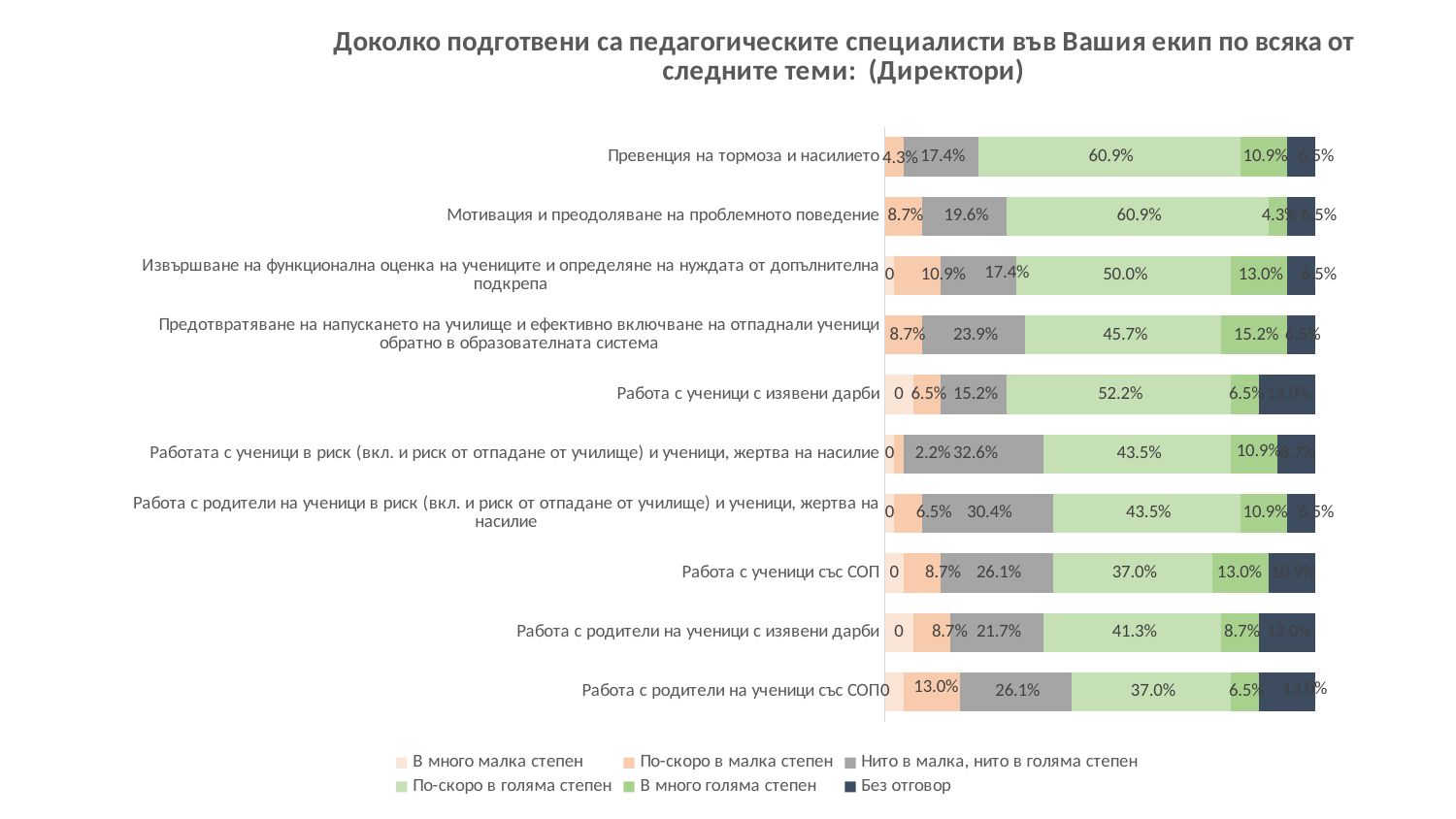
Which category has the highest value for "Нито в малка, нито в голяма степен"? Работата с ученици в риск (вкл. и риск от отпадане от училище) и ученици, жертва на насилие What is the value of "В много голяма степен" for "Предотвратяване на напускането на училище и ефективно включване на отпаднали ученици обратно в образователната система"? 15.2% How many series does the legend list? 6 How many categories (topics) are plotted in the chart? 10 What kind of chart is shown on the slide? Stacked bar chart What is the difference in "По-скоро в голяма степен" between "Мотивация и преодоляване на проблемното поведение" and "Предотвратяване на напускането на училище и ефективно включване на отпаднали ученици обратно в образователната система"? 15.2 percentage points Which has the larger "По-скоро в голяма степен" value: "Работа с ученици с изявени дарби" or "Извършване на функционална оценка на учениците и определяне на нуждата от допълнителна подкрепа"? Работа с ученици с изявени дарби What is the value of "По-скоро в малка степен" for "Работа с родители на ученици със СОП"? 13.0% What is the first series listed in the legend? В много малка степен What is the value of "По-скоро в голяма степен" for "Работа с ученици със СОП"? 37.0% What is the value of "По-скоро в голяма степен" for "Превенция на тормоза и насилието"? 60.9% What is the value of "Нито в малка, нито в голяма степен" for "Предотвратяване на напускането на училище и ефективно включване на отпаднали ученици обратно в образователната система"? 23.9%